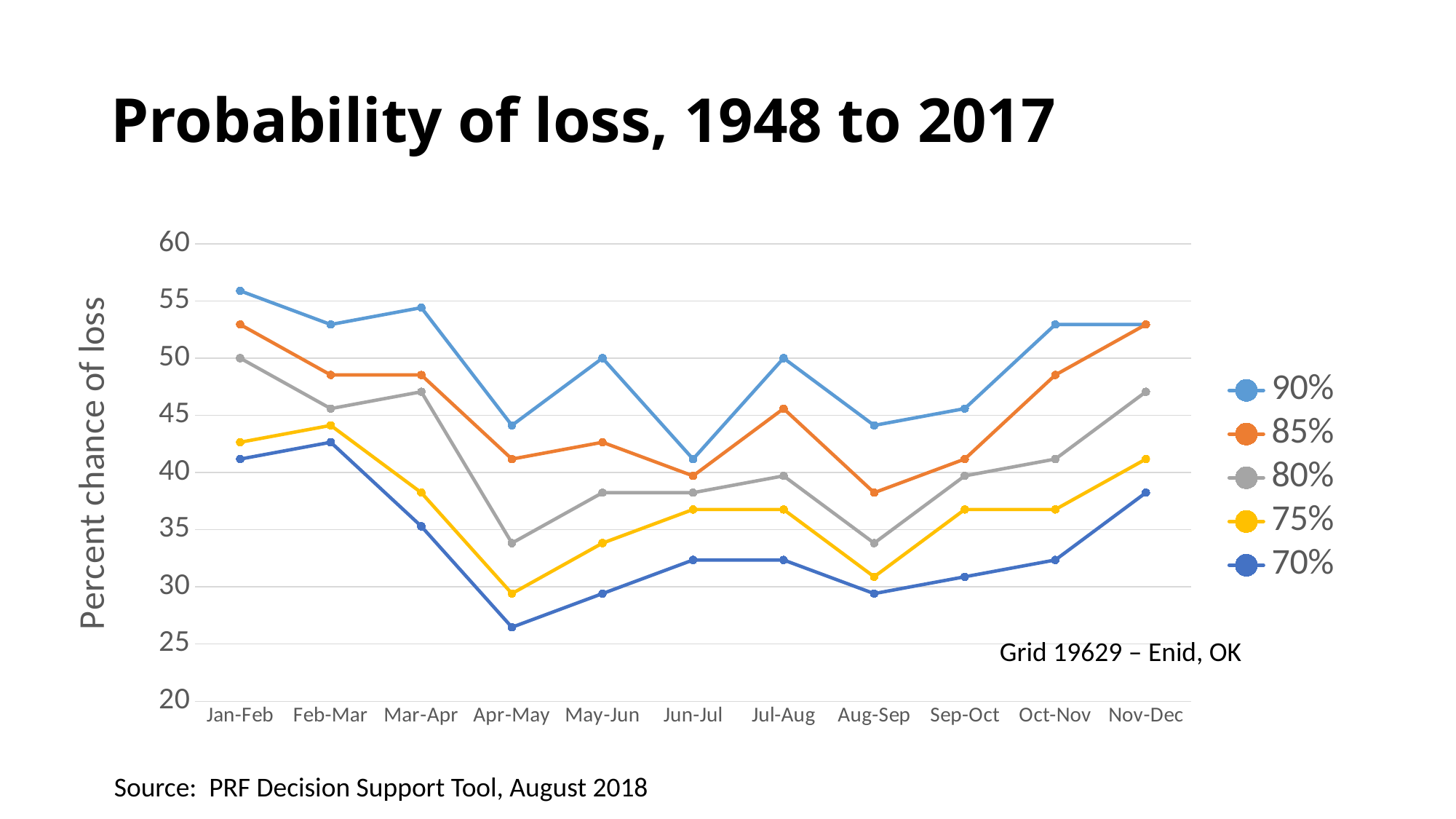
Is the value for the 70% series at Apr-May greater or less than 30? less Is the value for the 85% series at Nov-Dec greater or less than 50? greater Is the value for the 90% series at Jan-Feb greater or less than 50? greater What kind of chart is shown on the slide? line chart For the 70% series, which interval has the lowest probability of loss? Apr-May At Apr-May, which series has the higher value, 85% or 80%? 85% For the 90% series, which interval has the lowest probability of loss? Jun-Jul For the 90% series, which interval has the highest probability of loss? Jan-Feb Does the 70% series rise or fall from Jan-Feb to Apr-May? fall What is the title of the y axis? Percent chance of loss How many two-month intervals are shown along the x axis? 11 How many series does the legend list? 5